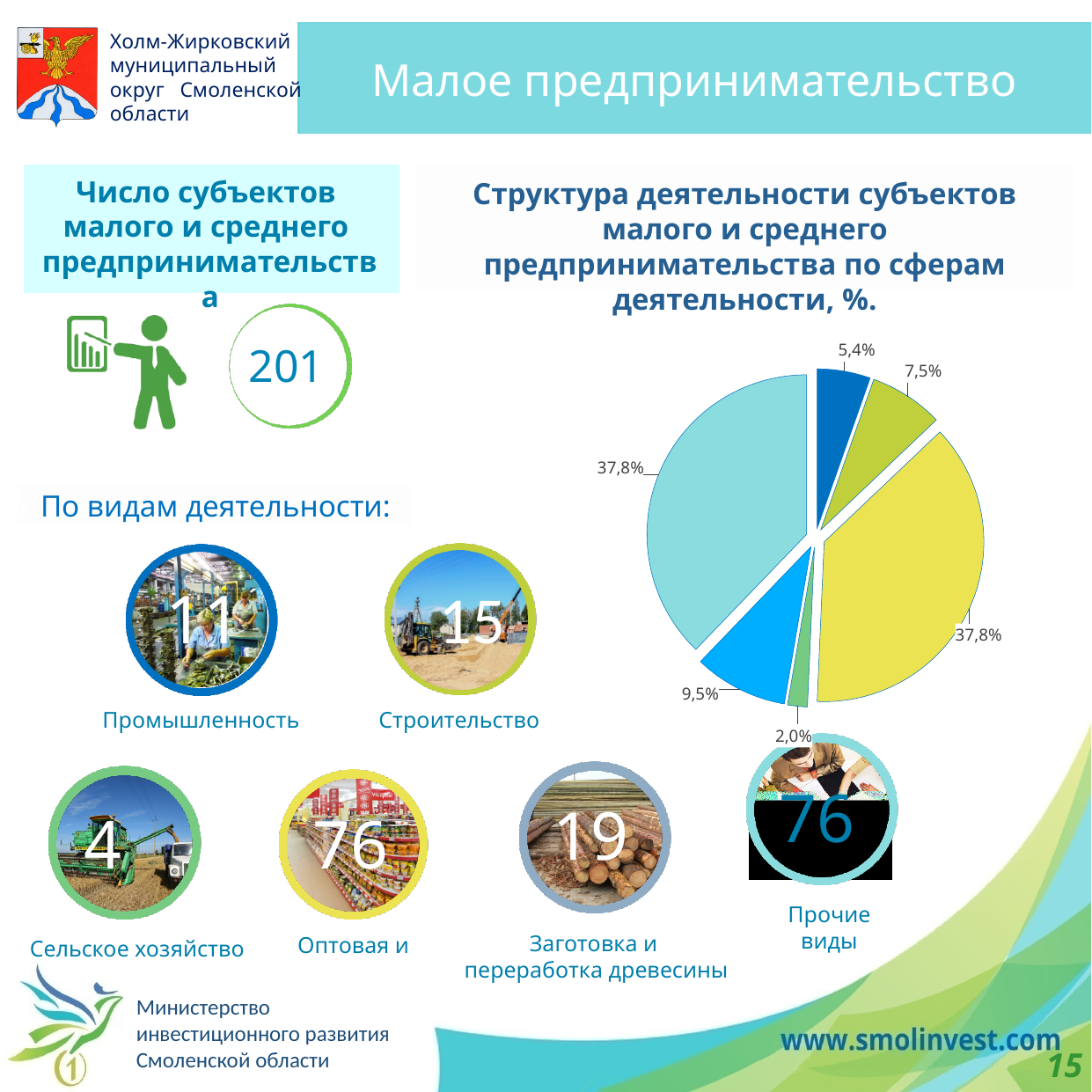
What is the difference between the 9,5% slice and the 7,5% slice? 2,0% What do all the percentage labels on the pie chart add up to? 100,0% What is the smallest percentage shown on the pie chart? 2,0% What is the title of the pie chart? Структура деятельности субъектов малого и среднего предпринимательства по сферам деятельности, %. What is the value of the yellow slice of the pie chart? 37,8% What is the value of the dark blue slice at the top of the pie chart? 5,4% What is the largest percentage shown on the pie chart? 37,8% Which is larger, the 9,5% slice or the 7,5% slice? 9,5% How many slices does the pie chart have? 6 What is the difference between the largest slice (37,8%) and the 5,4% slice? 32,4% How many slices of the pie chart are labelled 37,8%? 2 What kind of chart is shown on the slide? pie chart